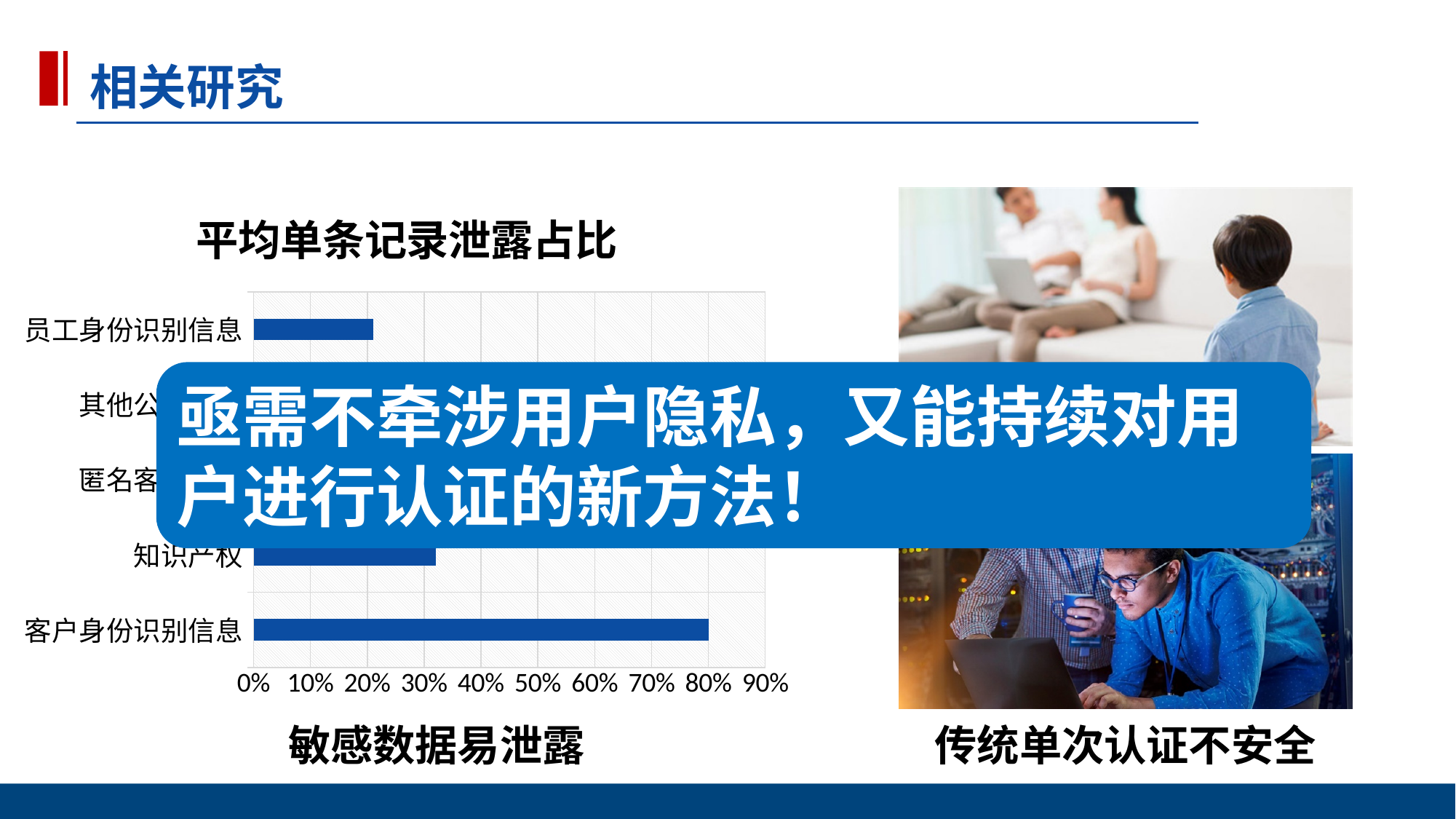
Which is larger, the value for 客户身份识别信息 or the value for 知识产权? 客户身份识别信息 What kind of chart is shown on the slide? bar chart What is the title of the chart? 平均单条记录泄露占比 Is the value for 知识产权 greater or less than 20%? greater Is the value for 客户身份识别信息 greater or less than 90%? less What is the highest tick label shown on the chart's horizontal axis? 90% How many categories are plotted in the chart? 5 Is the value for 员工身份识别信息 greater or less than 30%? less Which is larger, the value for 知识产权 or the value for 员工身份识别信息? 知识产权 Which category has the highest value in the chart? 客户身份识别信息